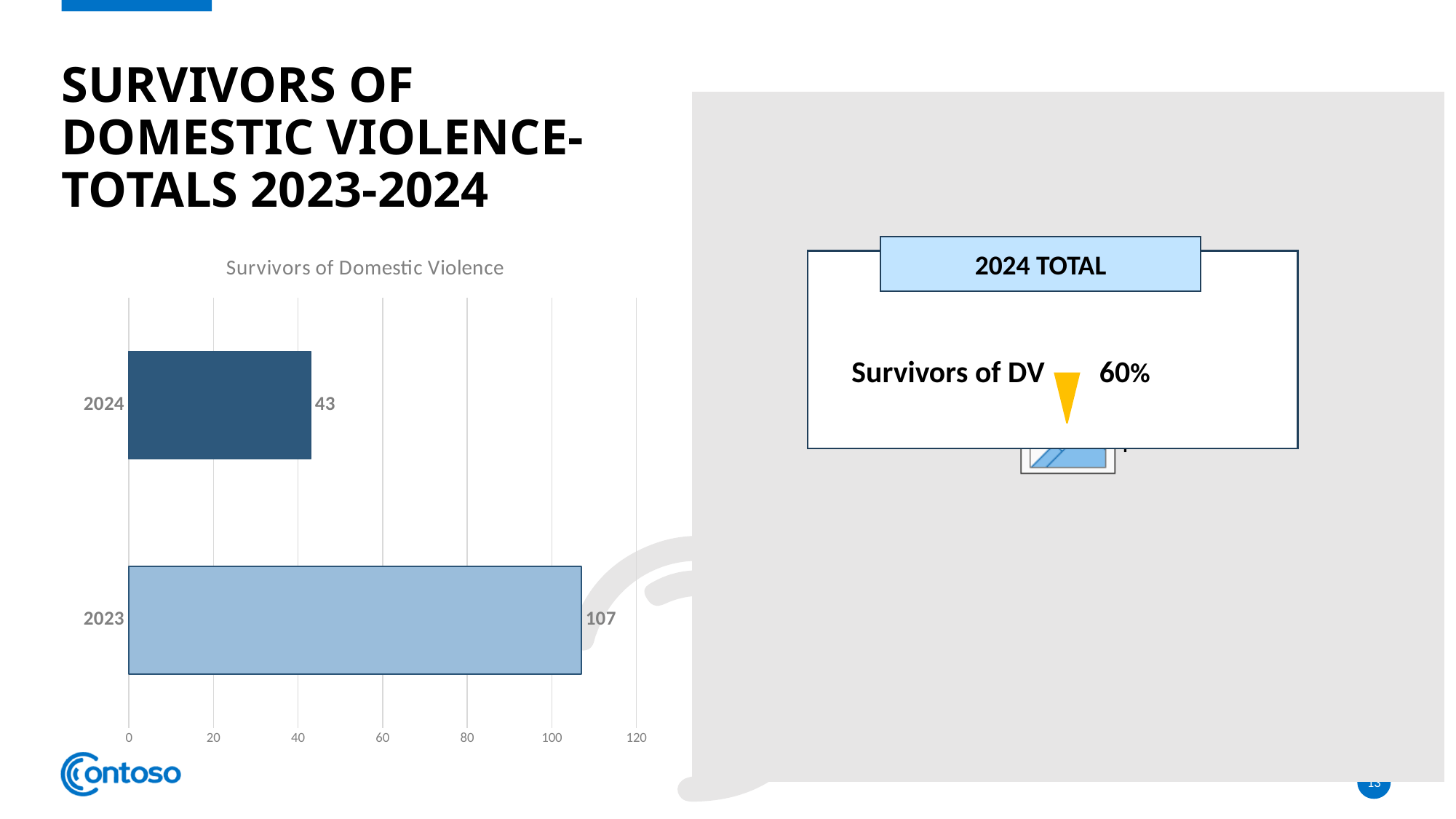
What is the difference between the 2023 and 2024 values in the Survivors of Domestic Violence chart? 64 Which year has the higher value in the Survivors of Domestic Violence chart? 2023 What is the value for 2023 in the Survivors of Domestic Violence chart? 107 What type of chart is the Survivors of Domestic Violence chart? bar chart Which year has the lower value in the Survivors of Domestic Violence chart? 2024 What is the title of the chart on the slide? Survivors of Domestic Violence What is the maximum value shown on the x axis of the Survivors of Domestic Violence chart? 120 What is the value for 2024 in the Survivors of Domestic Violence chart? 43 Is the value for 2023 greater or less than 100 in the Survivors of Domestic Violence chart? greater How many years are shown in the Survivors of Domestic Violence chart? 2 Is the value for 2023 larger or smaller than the value for 2024 in the Survivors of Domestic Violence chart? larger Is the value for 2024 greater or less than 60 in the Survivors of Domestic Violence chart? less